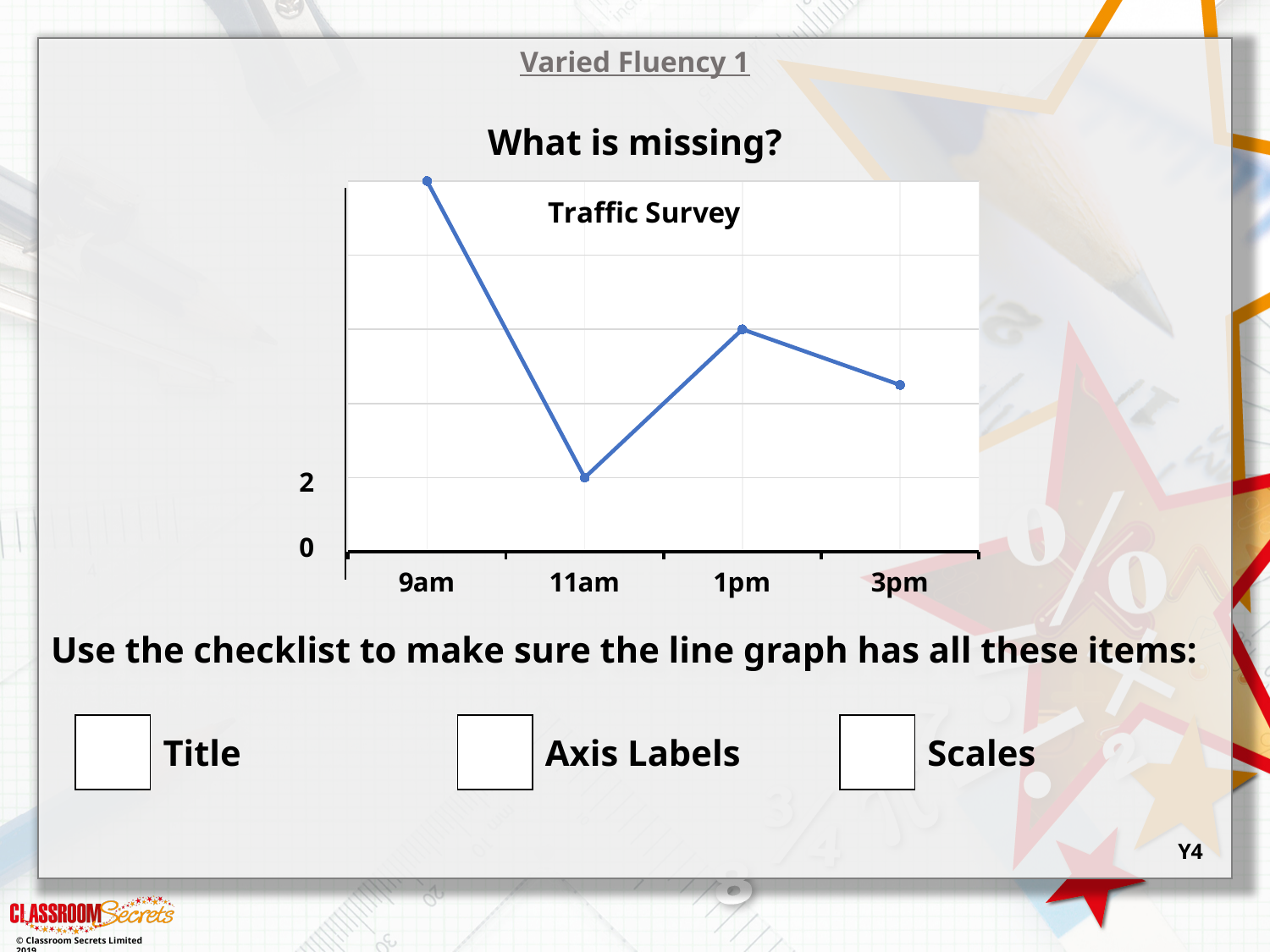
Which time has the highest value on the chart? 9am Which has the larger value, 1pm or 3pm? 1pm Does the line rise or fall from 9am to 11am? fall Which time has the lowest value on the chart? 11am Is the value for 9am greater or less than 2? greater Which has the larger value, 9am or 1pm? 9am Is the value for 3pm greater or less than 2? greater Does the line rise or fall from 11am to 1pm? rise How many time points are plotted on the chart? 4 What is the value plotted for 11am? 2 What is the title of the chart? Traffic Survey What kind of chart is shown on the slide? line chart